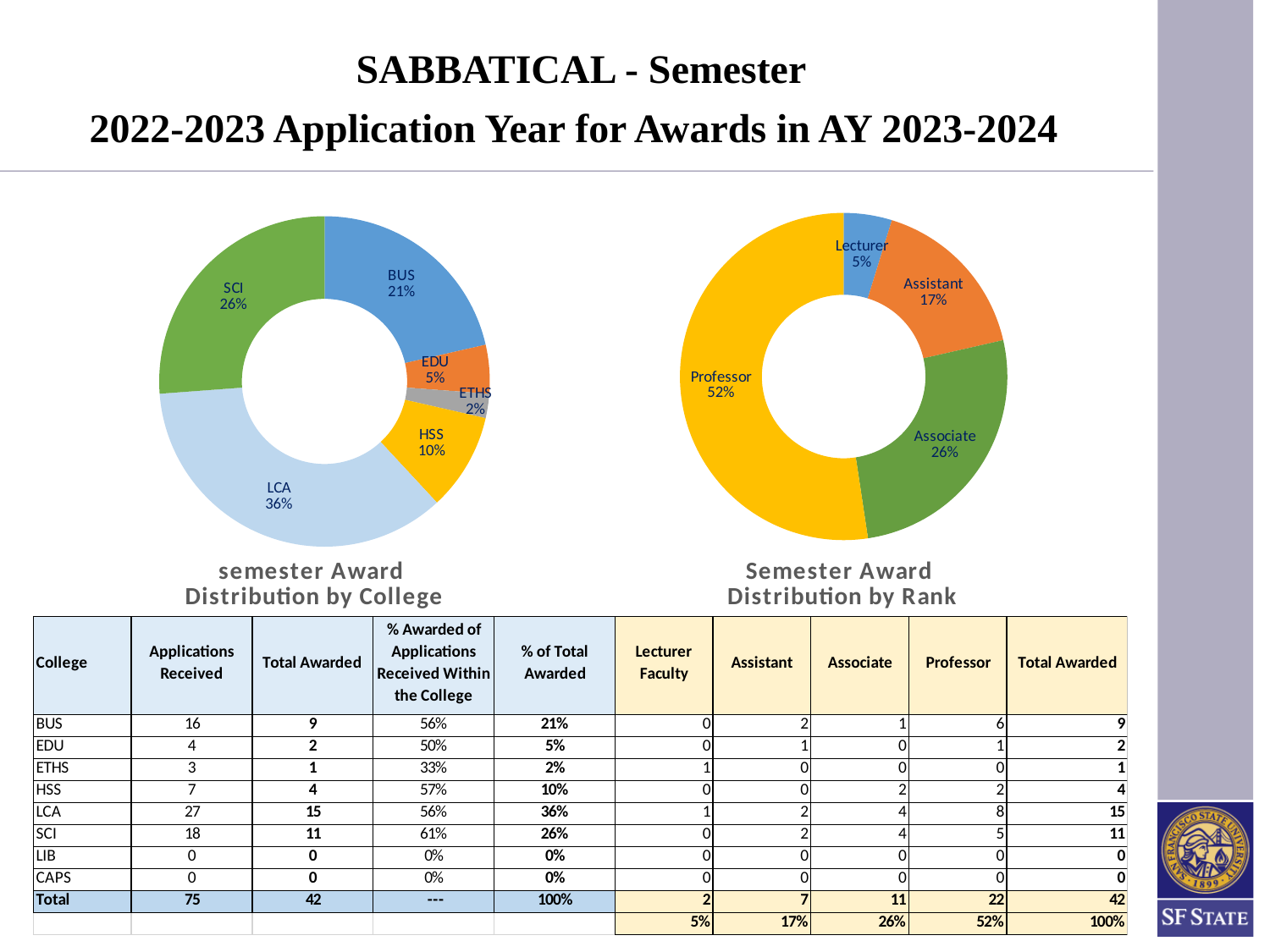
In the 'semester Award Distribution by College' chart, which college has the smallest share? ETHS In the 'semester Award Distribution by College' chart, which college has the largest share? LCA What type of chart is the 'Semester Award Distribution by Rank' chart? Doughnut chart In the 'semester Award Distribution by College' chart, what percentage is shown for LCA? 36% In the 'semester Award Distribution by College' chart, what is the difference in percentage points between SCI and BUS? 5 In the 'Semester Award Distribution by Rank' chart, which is larger, the share for Associate or the share for Assistant? Associate In the 'semester Award Distribution by College' chart, how many colleges are shown as slices? 6 In the 'semester Award Distribution by College' chart, what percentage is shown for HSS? 10% In the 'Semester Award Distribution by Rank' chart, what percentage is shown for Assistant? 17% In the 'Semester Award Distribution by Rank' chart, which rank has the smallest share? Lecturer In the 'Semester Award Distribution by Rank' chart, what percentage is shown for Professor? 52% In the 'Semester Award Distribution by Rank' chart, how many ranks are shown as slices? 4